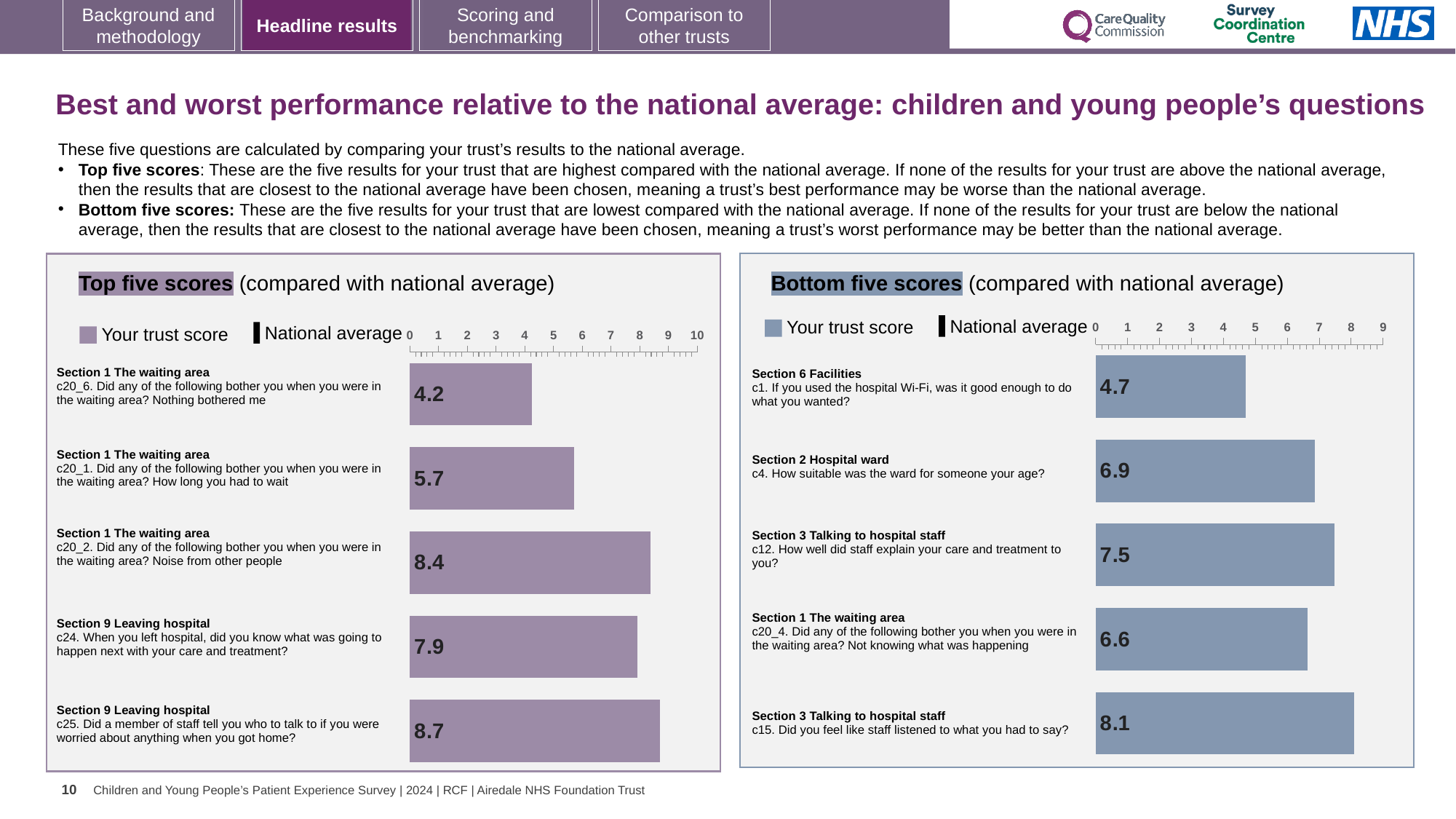
What type of chart is the Bottom five scores chart? Bar chart In the Bottom five scores chart, what is the trust score for c1 (hospital Wi-Fi)? 4.7 How many entries does the legend of the Top five scores chart list? 2 In the Top five scores chart, what is the difference between the trust scores for c20_2 (Noise from other people) and c20_1 (How long you had to wait)? 2.7 In the Top five scores chart, which question has the highest trust score? c25. Did a member of staff tell you who to talk to if you were worried about anything when you got home? How many questions are shown in the Top five scores chart? 5 In the Top five scores chart, what is the trust score for c25 (Did a member of staff tell you who to talk to if you were worried about anything when you got home)? 8.7 In the Bottom five scores chart, which question has the lowest trust score? c1. If you used the hospital Wi-Fi, was it good enough to do what you wanted? In the Top five scores chart, what is the trust score for c20_6 (Nothing bothered me in the waiting area)? 4.2 In the Bottom five scores chart, what is the difference between the trust scores for c15 and c20_4? 1.5 In the Bottom five scores chart, what is the trust score for c15 (Did you feel like staff listened to what you had to say)? 8.1 In the Bottom five scores chart, which has the larger trust score: c4 (How suitable was the ward for someone your age) or c12 (How well did staff explain your care and treatment)? c12. How well did staff explain your care and treatment to you?